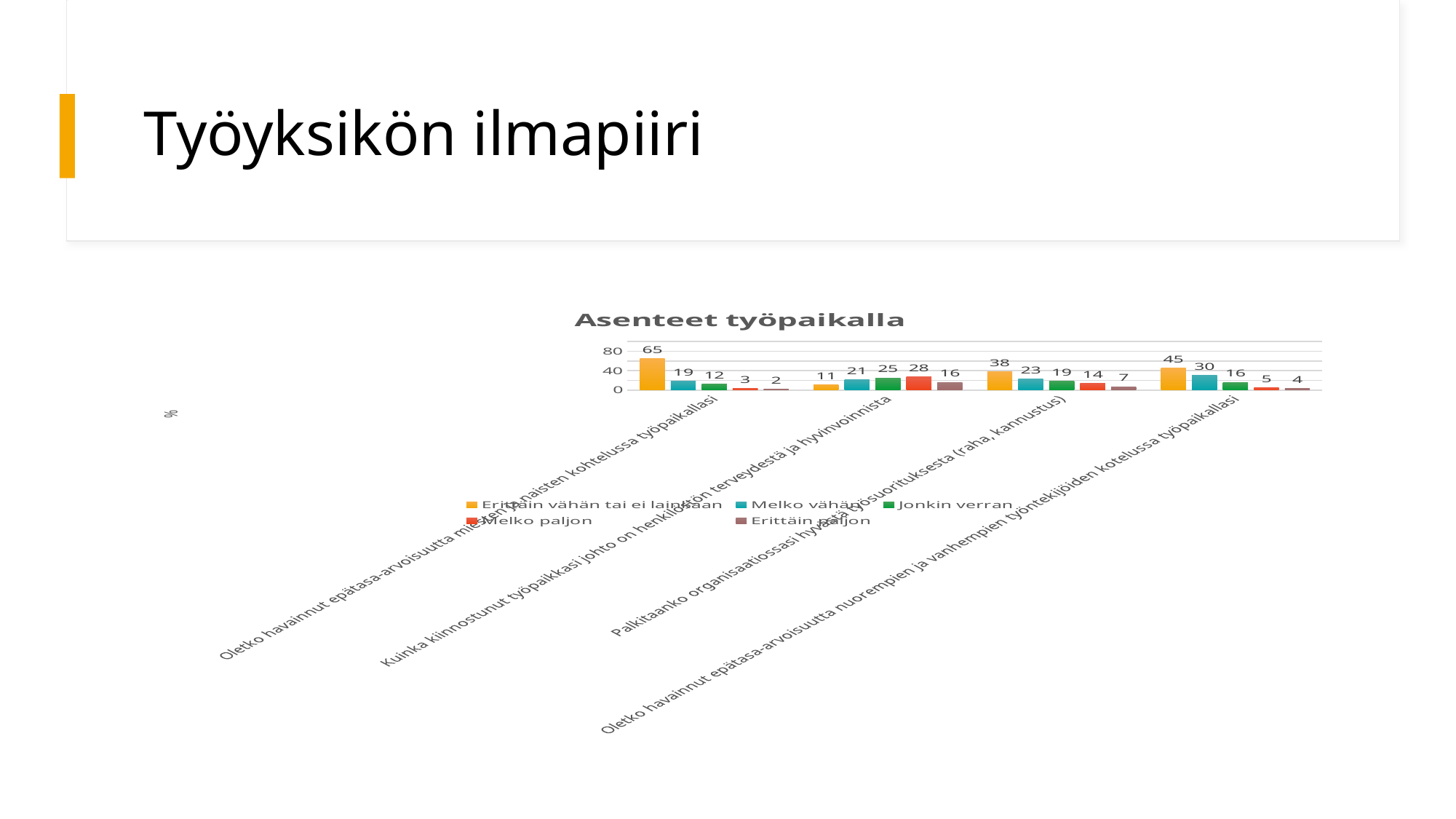
How many question categories are plotted along the x axis of the "Asenteet työpaikalla" chart? 4 Which series has the lowest value for "Palkitaanko organisaatiossasi hyvästä työsuorituksesta (raha, kannustus)"? Erittäin paljon How many series does the legend of the "Asenteet työpaikalla" chart list? 5 Which series has the highest value for "Kuinka kiinnostunut työpaikkasi johto on henkilöstön terveydestä ja hyvinvoinnista"? Melko paljon Which is larger for "Palkitaanko organisaatiossasi hyvästä työsuorituksesta (raha, kannustus)": "Melko vähän" or "Jonkin verran"? Melko vähän What is the difference between the "Erittäin vähän tai ei lainkaan" value for the first (leftmost) category and the same series for "Oletko havainnut epätasa-arvoisuutta nuorempien ja vanhempien työntekijöiden kotelussa työpaikallasi"? 20 What kind of chart is shown under the title "Asenteet työpaikalla"? bar chart What is the value of "Erittäin vähän tai ei lainkaan" for the first (leftmost) category in the "Asenteet työpaikalla" chart? 65 What is the value of "Melko paljon" for "Kuinka kiinnostunut työpaikkasi johto on henkilöstön terveydestä ja hyvinvoinnista"? 28 What is the value of "Melko vähän" for "Oletko havainnut epätasa-arvoisuutta nuorempien ja vanhempien työntekijöiden kotelussa työpaikallasi"? 30 What colour represents the "Erittäin vähän tai ei lainkaan" series in the "Asenteet työpaikalla" chart? orange What is the value of "Erittäin paljon" for "Palkitaanko organisaatiossasi hyvästä työsuorituksesta (raha, kannustus)"? 7